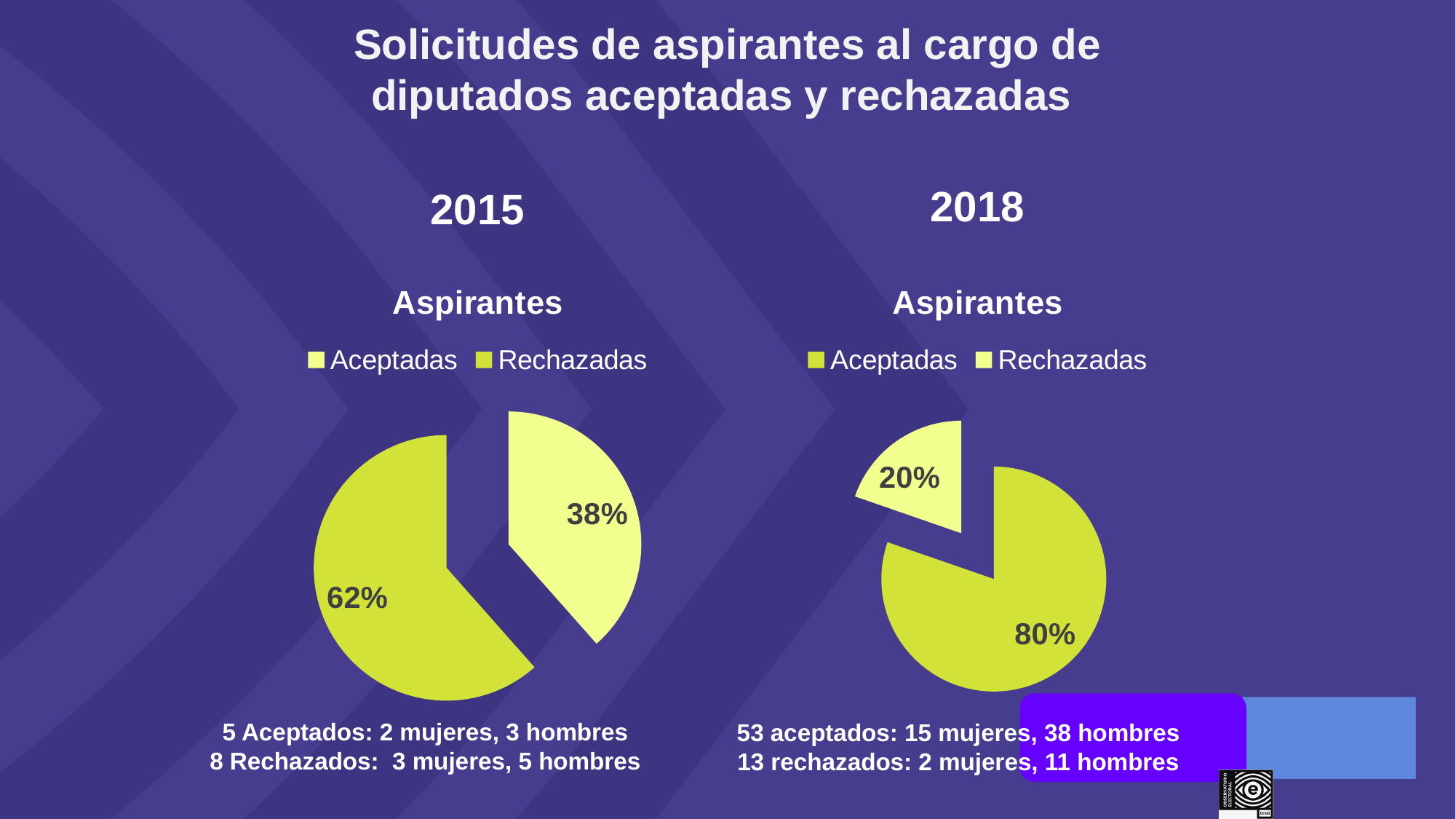
In the 2018 pie chart, what share of applications were Aceptadas? 80% In the 2015 pie chart, which category has the larger slice? Rechazadas In the 2015 pie chart, what share of applications were Rechazadas? 62% In the 2018 pie chart, what is the difference in percentage points between Aceptadas and Rechazadas? 60 In the 2018 pie chart, which category has the smaller slice? Rechazadas In the 2015 pie chart, what share of applications were Aceptadas? 38% In the 2015 pie chart, what is the difference in percentage points between Rechazadas and Aceptadas? 24 How many categories does the legend of the 2018 pie chart list? 2 Which is larger: the Aceptadas share in the 2015 chart or the Aceptadas share in the 2018 chart? 2018 In the 2018 pie chart, what share of applications were Rechazadas? 20% What type of chart is used for the 2015 Aspirantes data? Pie chart What is the title shown above each of the two pie charts? Aspirantes